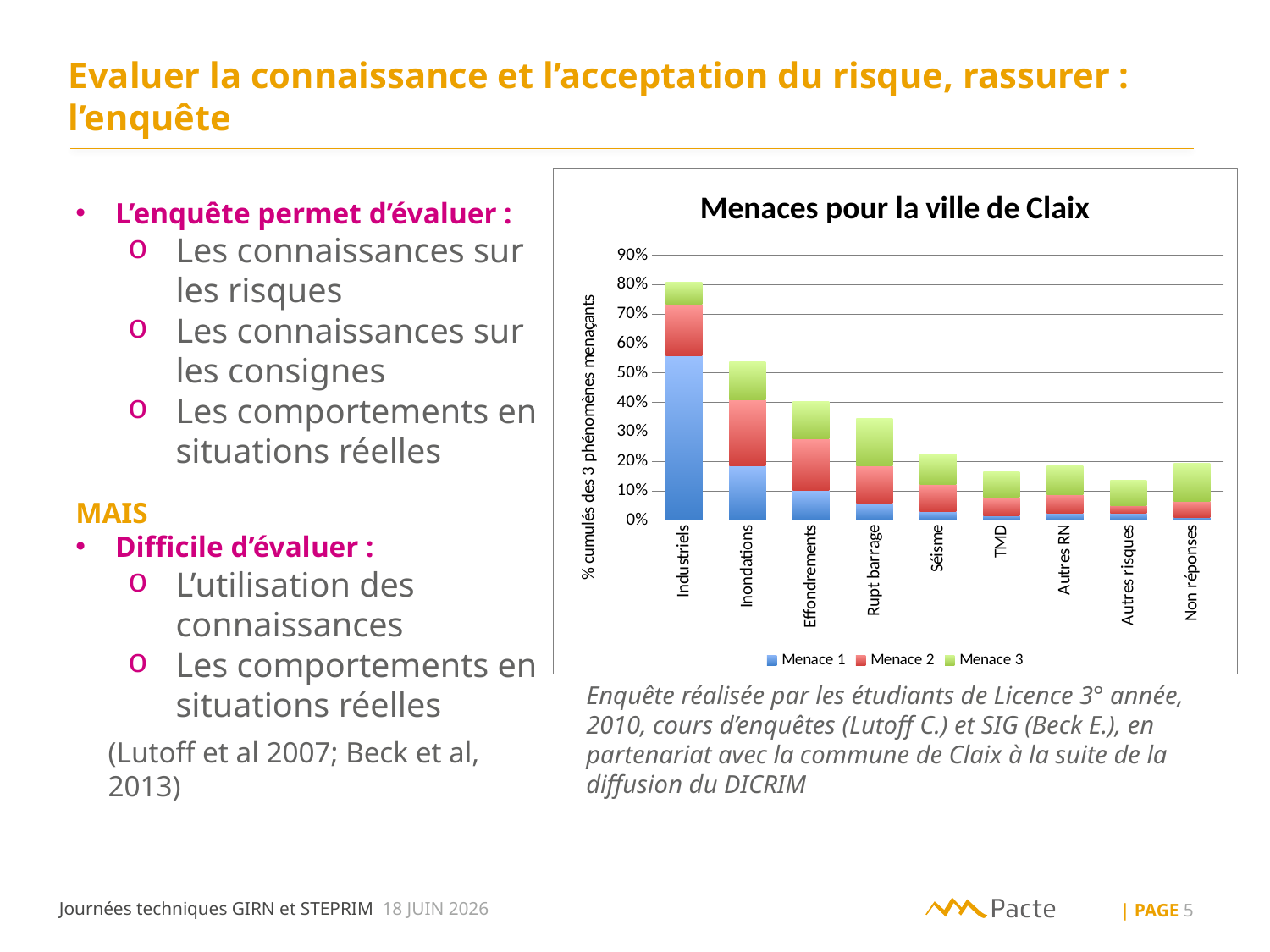
Which has the larger total bar, Inondations or Effondrements? Inondations Is the total value for TMD greater or less than 20%? less Which category has the highest total bar? Industriels What is the title of the chart? Menaces pour la ville de Claix How many categories are shown on the x axis of the chart? 9 Is the total value for Effondrements greater or less than 50%? less Is the total value for Industriels greater or less than 70%? greater Which has the larger total bar, Rupt barrage or Séisme? Rupt barrage What kind of chart is shown on the slide? Stacked bar chart Which colour represents Menace 1 in the legend? Blue How many series does the legend list? 3